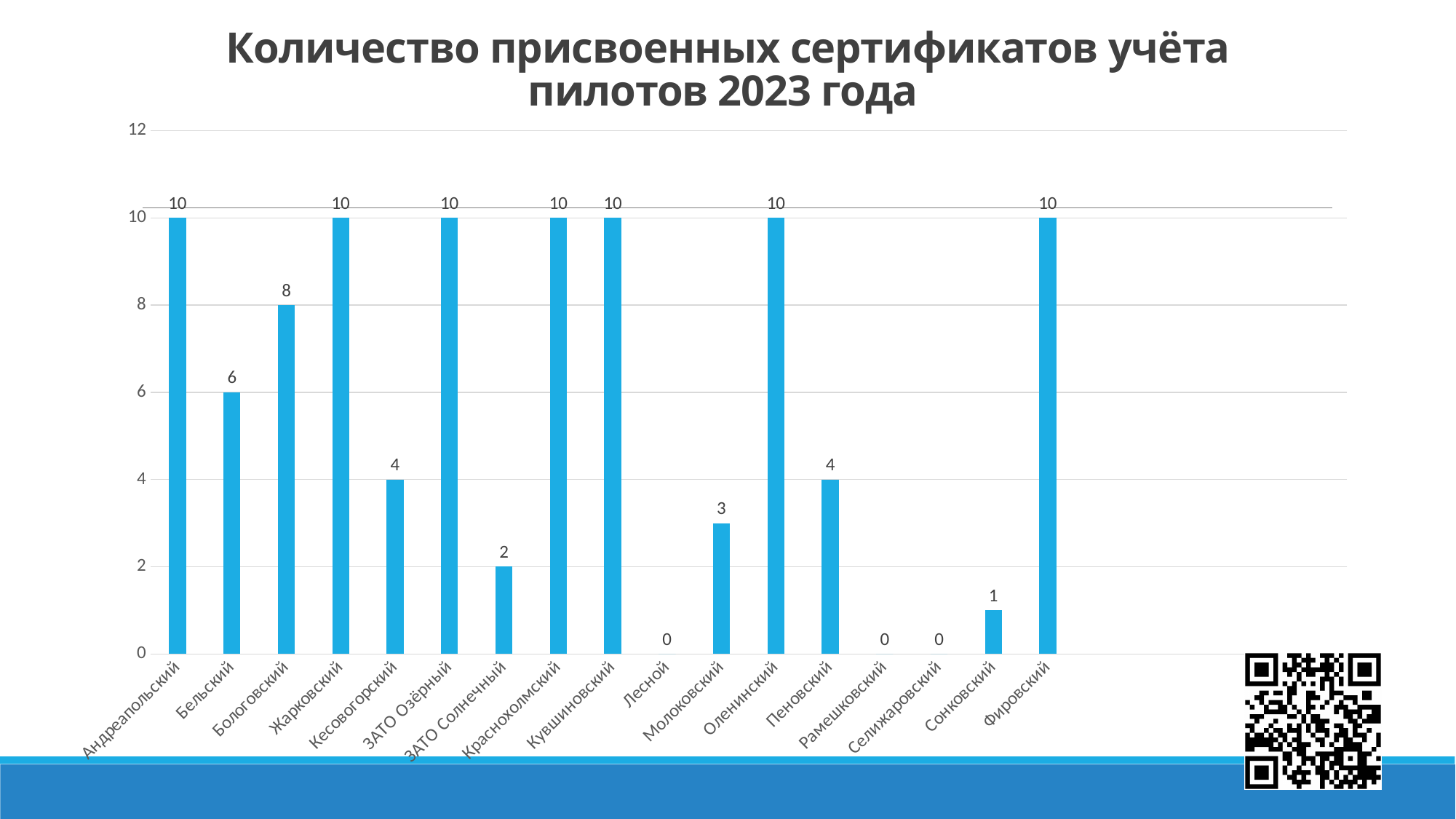
What is the value for Сонковский? 1 What is the difference between the values for Бологовский and Бельский? 2 What is the value for Молоковский? 3 What is the value for ЗАТО Солнечный? 2 Which is larger, the value for Кесовогорский or the value for Молоковский? Кесовогорский What kind of chart is shown on the slide? Bar chart What is the title of the chart? Количество присвоенных сертификатов учёта пилотов 2023 года What is the value for Бельский? 6 What is the value for Лесной? 0 How many categories have a value of 10? 7 How many categories are shown on the x axis? 17 What is the value for Бологовский? 8